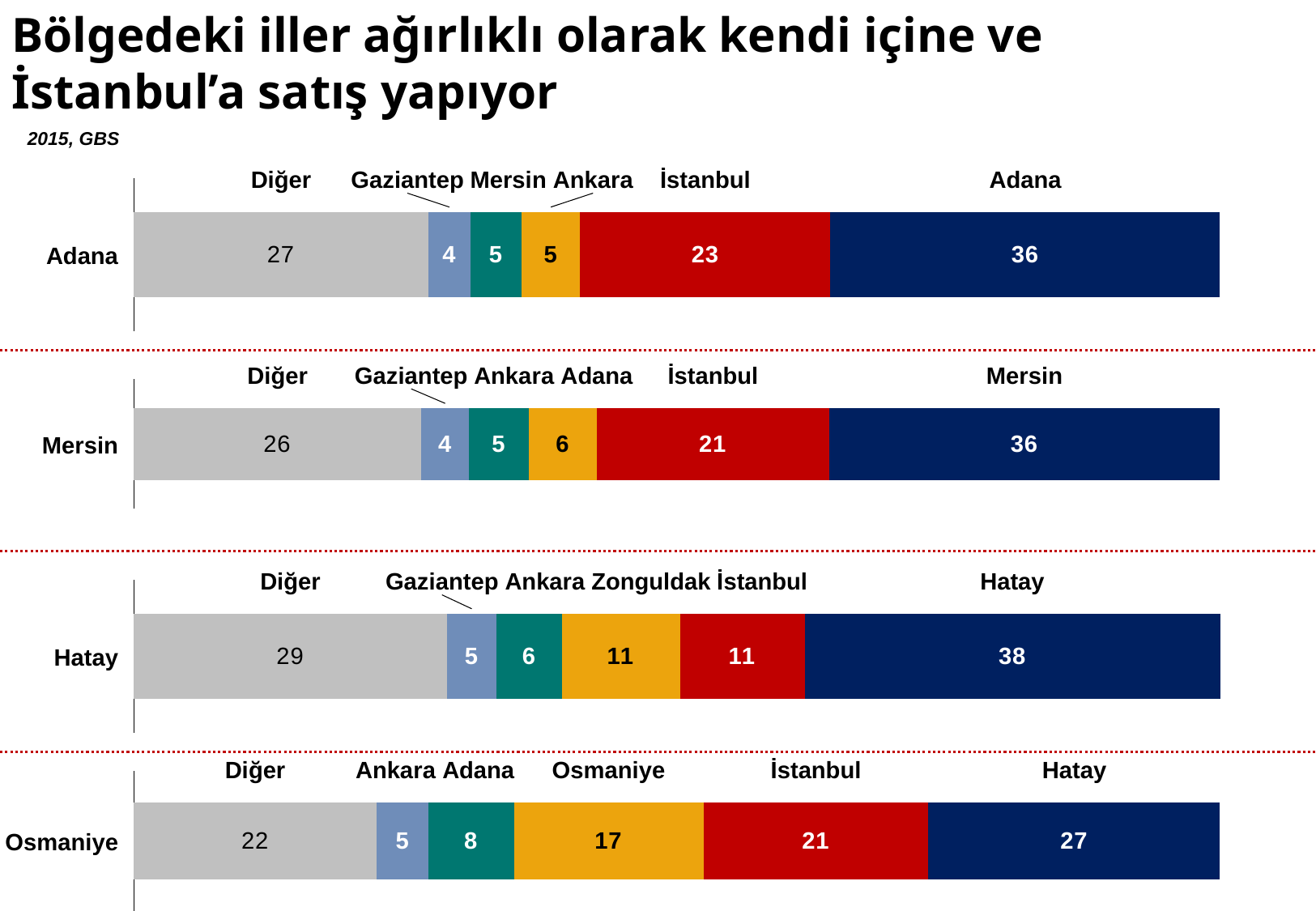
In the Adana bar, what is the difference between the Adana segment and the İstanbul segment? 13 In the Osmaniye bar, what is the value for the Osmaniye segment? 17 How many province bars are shown on the slide? 4 In the Hatay bar, what is the value for Zonguldak? 11 In the Osmaniye bar, which is larger, the Hatay segment or the İstanbul segment? Hatay In the Adana bar, what is the value for İstanbul? 23 In the Hatay bar, which segment has the highest value? Hatay What is the total of the Osmaniye stacked bar? 100 How many segments does the Mersin bar have? 6 What kind of chart is shown on the slide? Stacked bar chart In the Osmaniye bar, which segment has the lowest value? Ankara In the Mersin bar, what is the value for the Mersin segment? 36